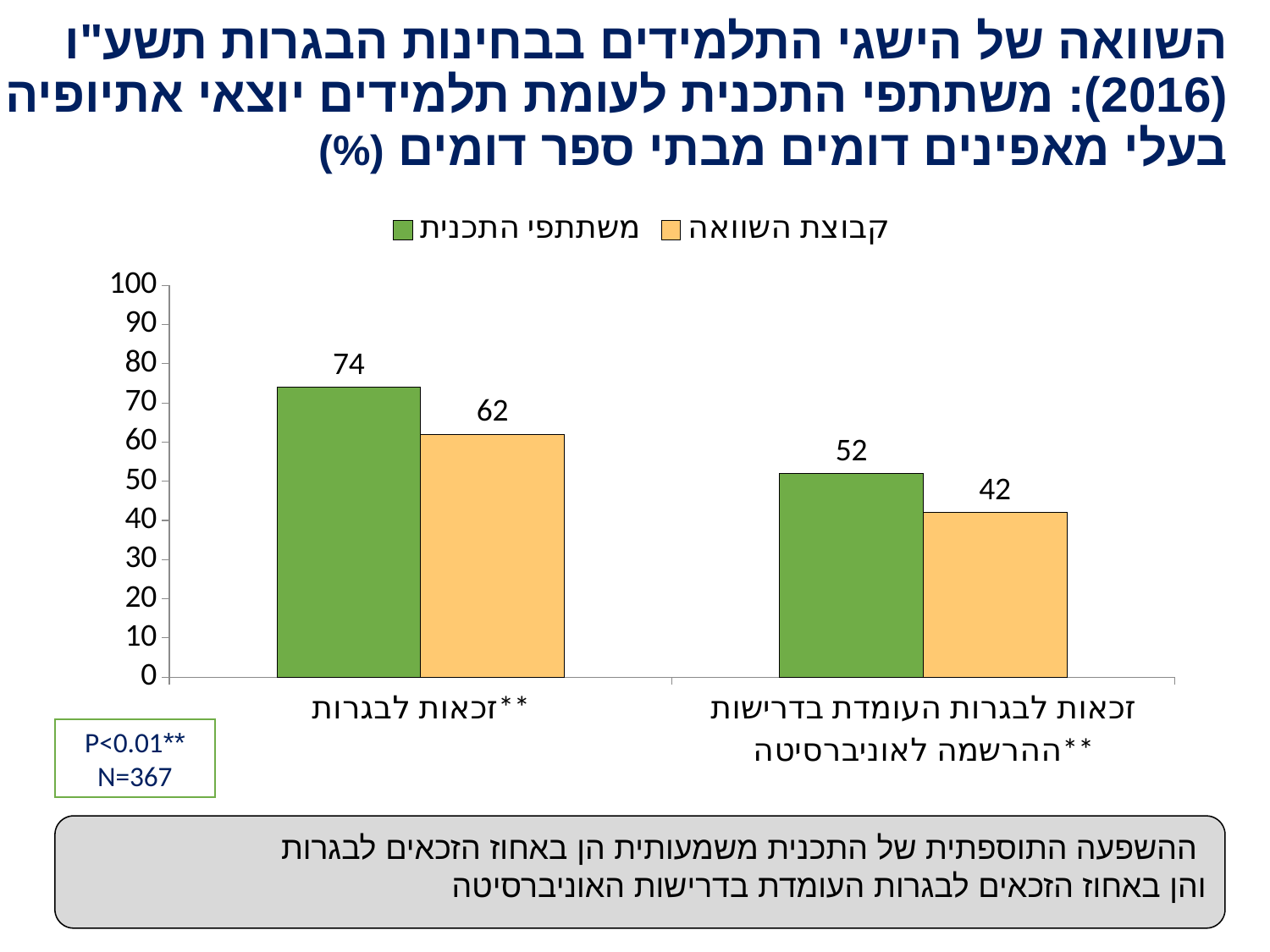
Which bar has the lowest value in the chart? קבוצת השוואה in זכאות לבגרות העומדת בדרישות ההרשמה לאוניברסיטה How many categories are shown on the x axis? 2 What is the difference between משתתפי התכנית and קבוצת השוואה in the זכאות לבגרות category? 12 What is the value for משתתפי התכנית in the זכאות לבגרות category? 74 What is the value for קבוצת השוואה in the זכאות לבגרות העומדת בדרישות ההרשמה לאוניברסיטה category? 42 What is the difference between משתתפי התכנית and קבוצת השוואה in the זכאות לבגרות העומדת בדרישות ההרשמה לאוניברסיטה category? 10 Which bar has the highest value in the chart? משתתפי התכנית in זכאות לבגרות Which series has the higher value in the זכאות לבגרות category? משתתפי התכנית What kind of chart is shown on the slide? Bar chart What is the value for משתתפי התכנית in the זכאות לבגרות העומדת בדרישות ההרשמה לאוניברסיטה category? 52 How many series does the legend list? 2 What is the value for קבוצת השוואה in the זכאות לבגרות category? 62